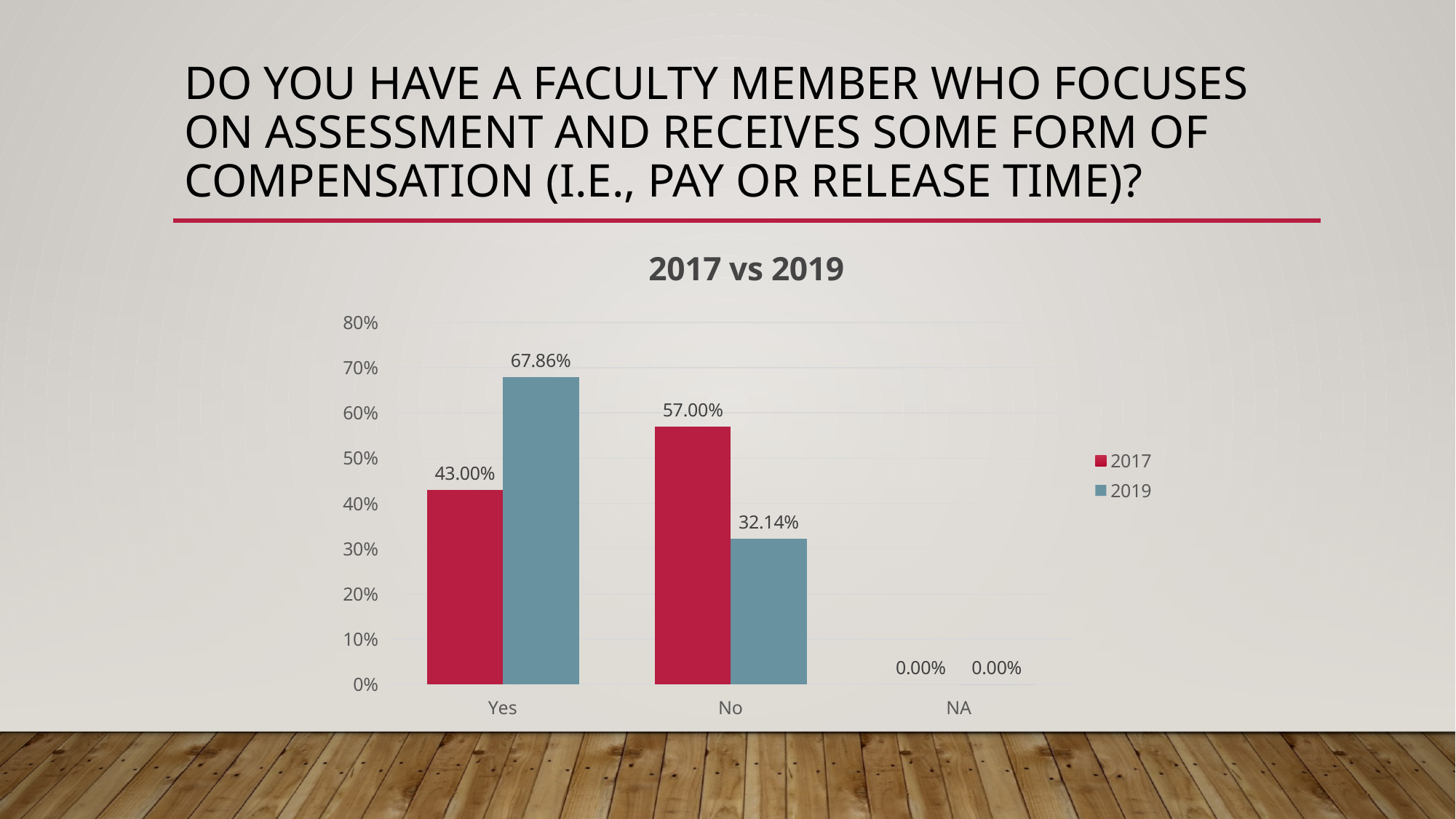
What kind of chart is shown on the slide? Bar chart How many categories are shown on the x axis? 3 What is the value for NA in the 2019 series? 0.00% What is the value for Yes in the 2019 series? 67.86% What is the value for Yes in the 2017 series? 43.00% What is the title of the chart? 2017 vs 2019 How many series does the legend list? 2 Which category has the highest value in the 2019 series? Yes What is the value for No in the 2017 series? 57.00% Which category has the lowest value in the 2017 series? NA Which is larger for No: the 2017 value or the 2019 value? 2017 What is the difference between the 2019 and 2017 values for Yes? 24.86%